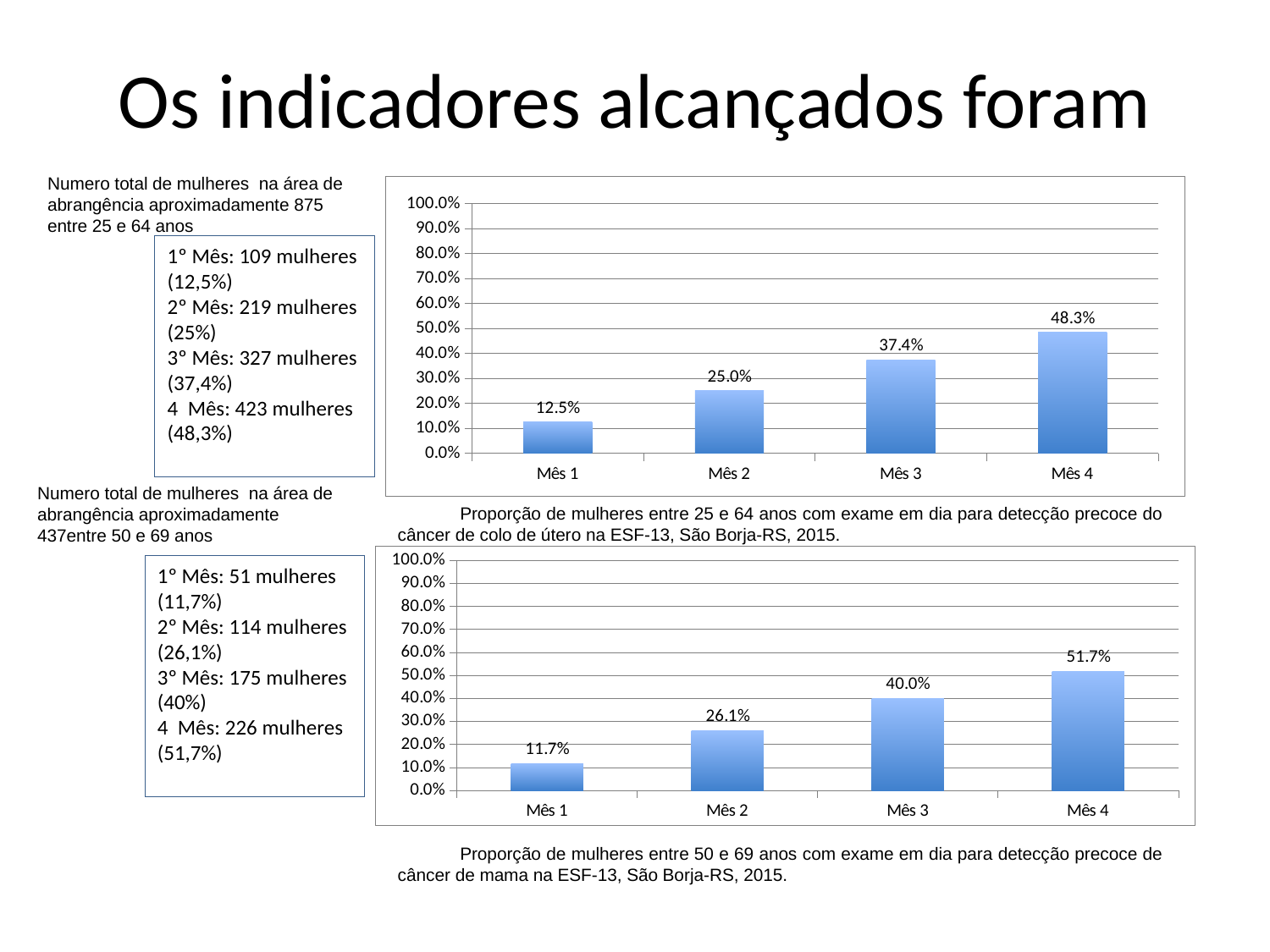
In the top chart (cervical cancer screening), which month has the highest value? Mês 4 In the bottom chart (breast cancer screening), what is the difference between the values for Mês 3 and Mês 2? 13.9% How many categories (months) are shown on the x axis of the top chart? 4 In the bottom chart (breast cancer screening, women 50 to 69), what is the value for Mês 2? 26.1% In the top chart (cervical cancer screening), is the value for Mês 4 greater or less than 50.0%? less In the bottom chart (breast cancer screening), which is larger, the value for Mês 3 or Mês 4? Mês 4 In the top chart (cervical cancer screening), do the values rise or fall from Mês 1 to Mês 4? Rise In the top chart (cervical cancer screening, women 25 to 64), what is the value for Mês 3? 37.4% In the top chart (cervical cancer screening), what is the difference between the values for Mês 4 and Mês 1? 35.8% In the bottom chart (breast cancer screening), which month has the lowest value? Mês 1 What is the value for Mês 1 in the bottom chart (breast cancer screening)? 11.7% What kind of chart is the bottom chart (breast cancer screening)? Bar chart